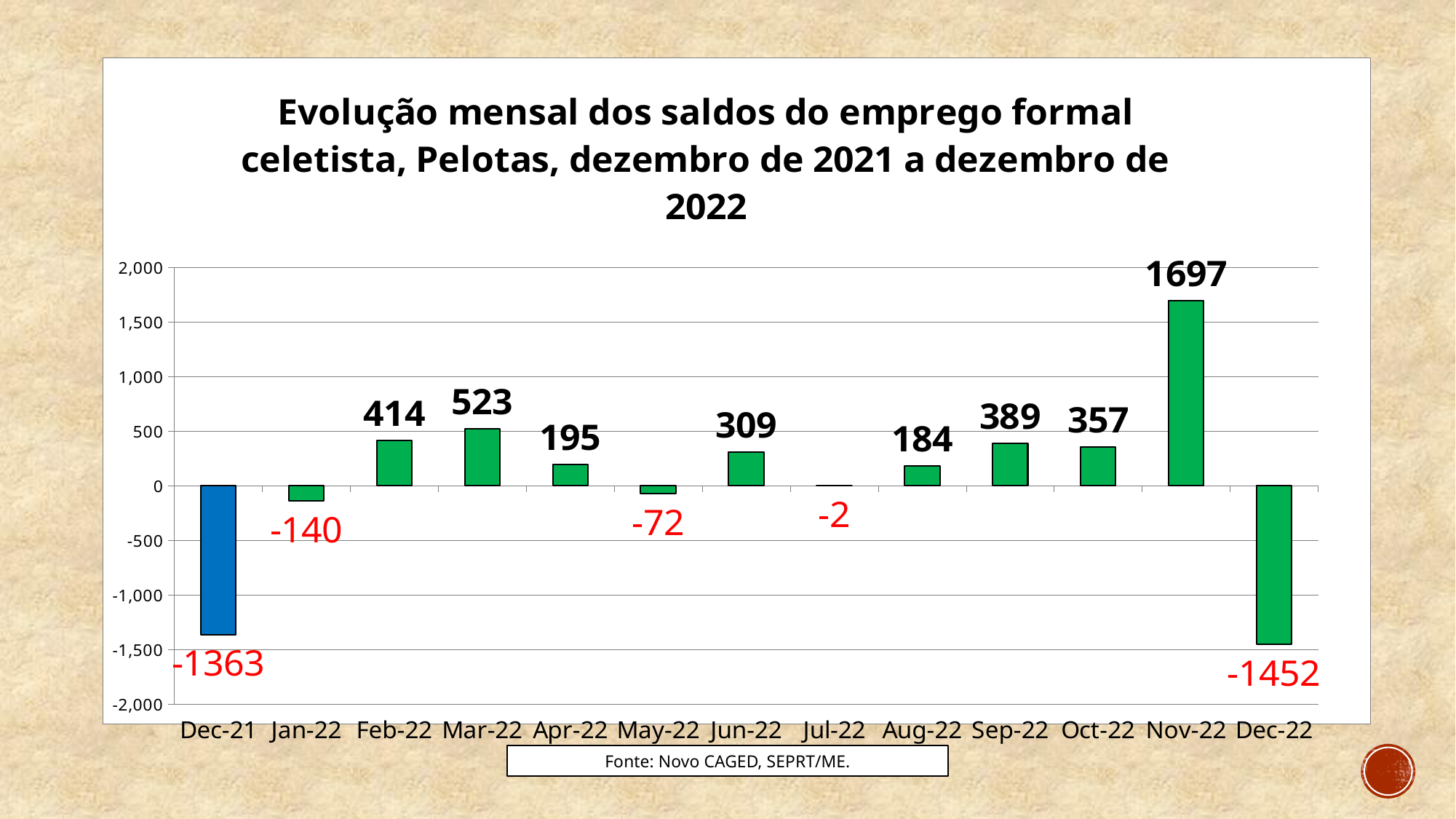
What is the value for Mar-22? 523 What kind of chart is shown on the slide? bar chart What is the value for Nov-22? 1697 Which month has the lowest value? Dec-22 What colour is the bar for Dec-21? blue What is the value for Dec-21? -1363 Which month has the highest value? Nov-22 What is the value for Jul-22? -2 Is the value for Dec-22 greater or less than -1,000? less What is the difference between the values for Nov-22 and Oct-22? 1340 How many months are shown on the x axis? 13 Which is larger, the value for Feb-22 or the value for Sep-22? Feb-22